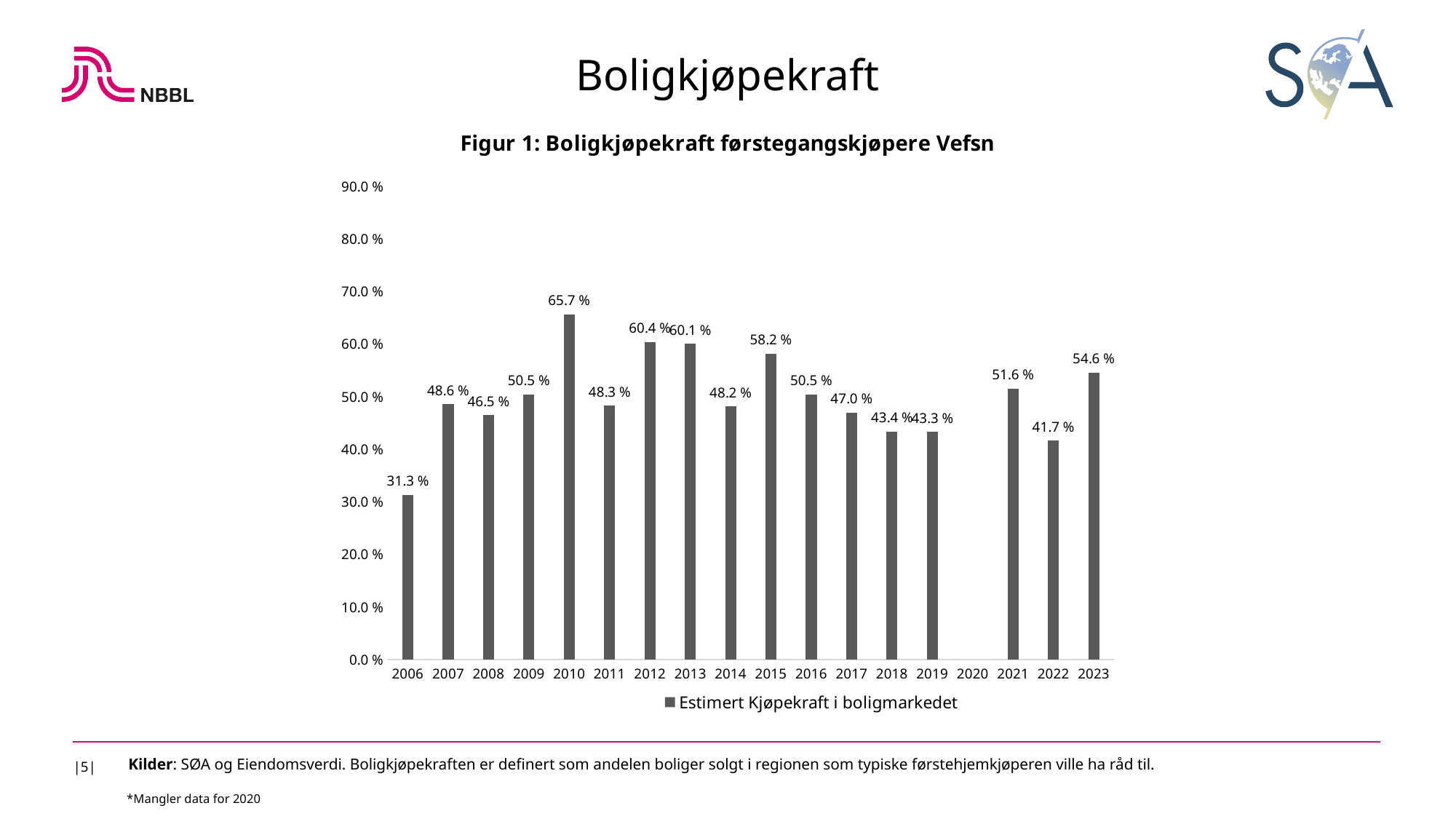
Which year has no bar in the chart? 2020 How many years are shown on the x axis of the chart? 18 What kind of chart is shown on the slide? bar chart Do the values rise or fall from 2016 to 2019? fall Which year has the highest value in the chart? 2010 Is the value for 2022 greater or less than 50.0 %? less Which is larger, the value for 2015 or the value for 2021? 2015 Which year has the lowest value in the chart? 2006 What is the value for 2006 in the chart? 31.3 % What is the value for 2010 in the chart? 65.7 % What is the value for 2023 in the chart? 54.6 % What is the difference between the values for 2023 and 2022? 12.9 percentage points